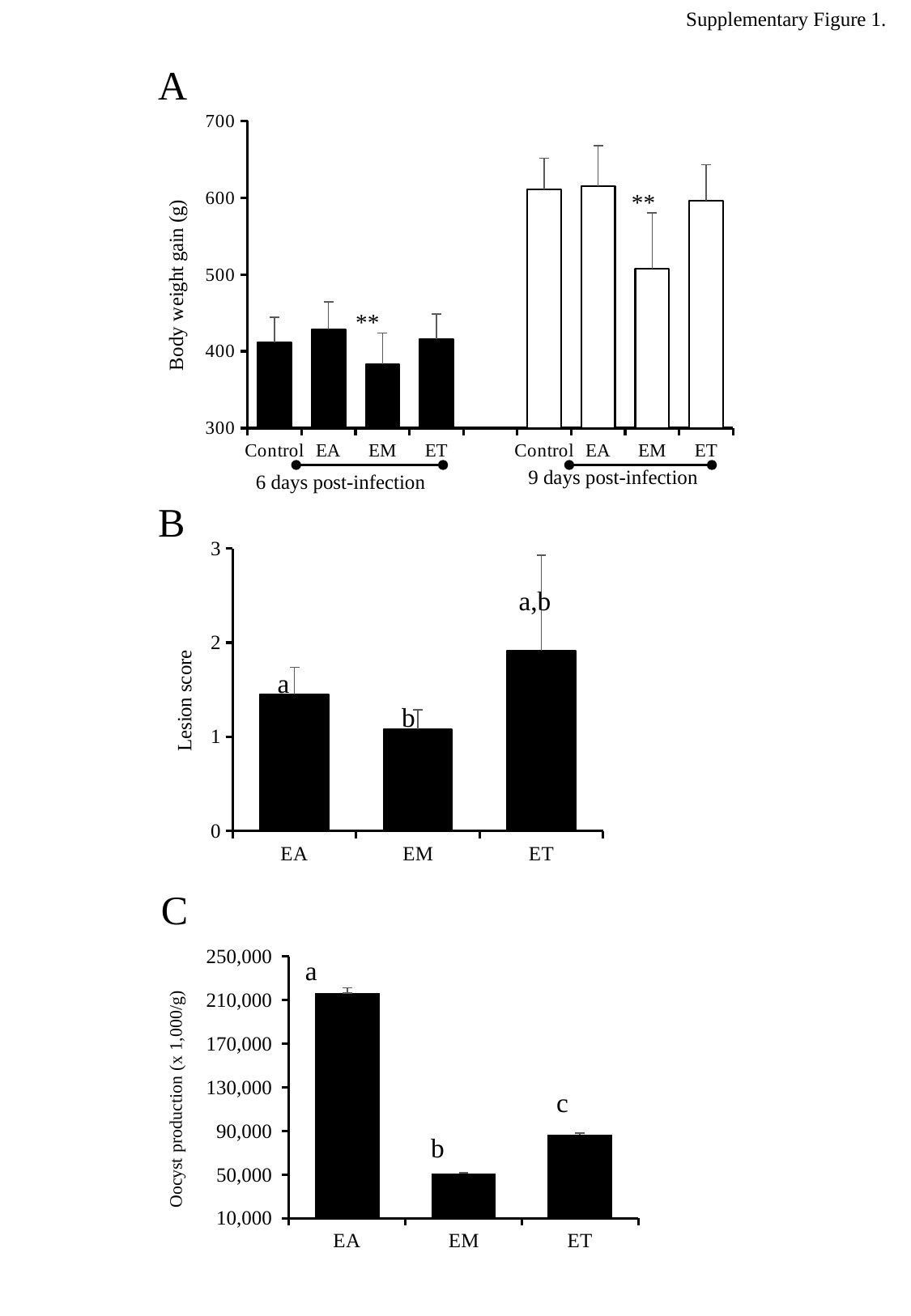
In chart C (Oocyst production), is the value for EA greater or less than 170,000? greater In chart A (Body weight gain), how many bars are plotted in total? 8 In chart B (Lesion score), which group has the lowest lesion score? EM In chart A (Body weight gain), is the value for EM at 6 days post-infection greater or less than 400? less In chart C (Oocyst production), which group has the highest oocyst production? EA In chart A (Body weight gain), is the value for Control at 9 days post-infection greater or less than 600? greater What kind of chart is chart C (Oocyst production)? bar chart In chart A (Body weight gain), which group has the lowest body weight gain at 6 days post-infection? EM In chart A (Body weight gain), which is larger: the value for EM at 9 days post-infection or the value for ET at 9 days post-infection? ET at 9 days post-infection In chart C (Oocyst production), which is larger: the value for EM or the value for ET? ET In chart B (Lesion score), which group has the highest lesion score? ET